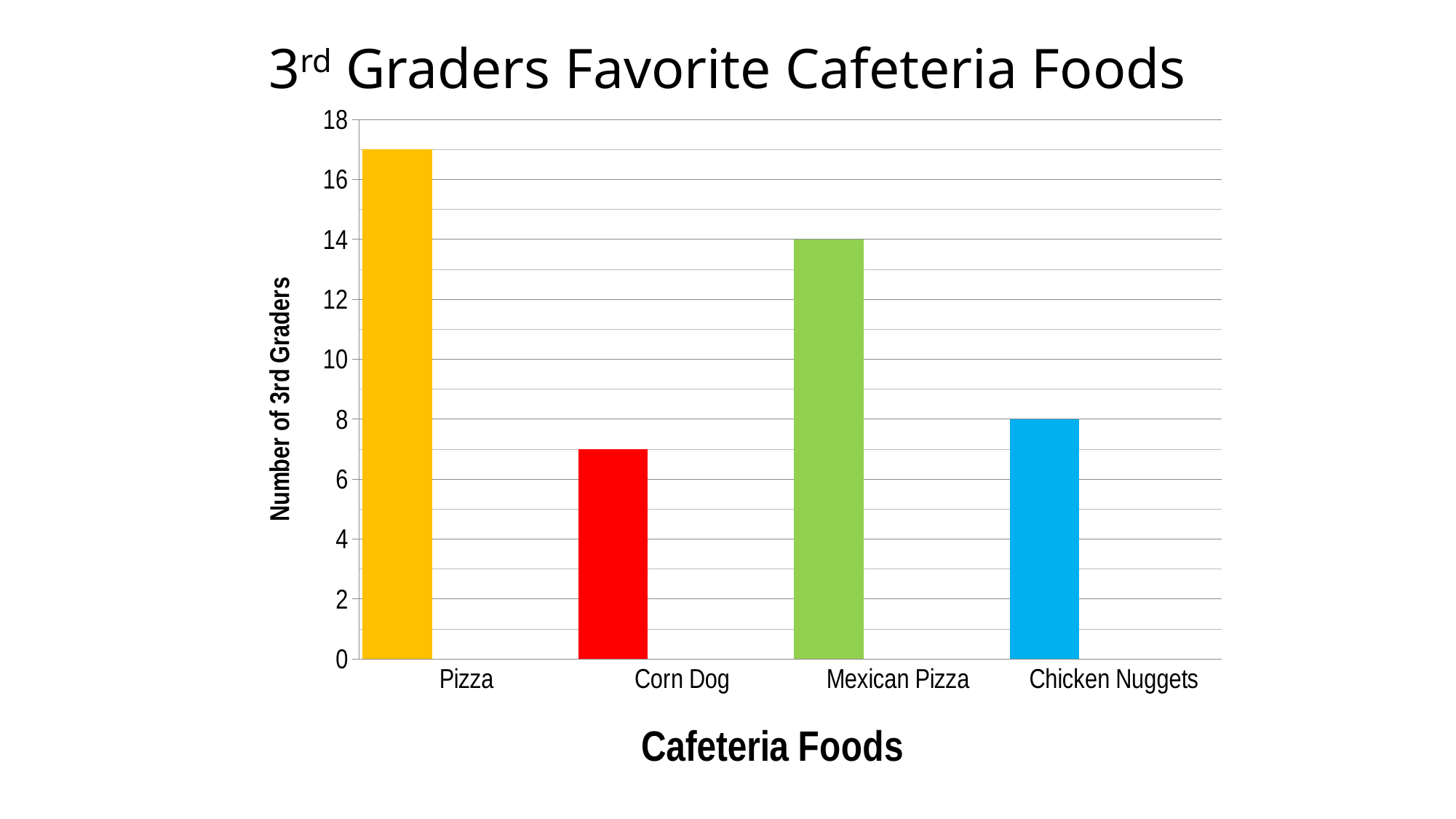
What is the difference between the number of 3rd graders who chose Mexican Pizza and those who chose Chicken Nuggets? 6 Which has more 3rd graders, Pizza or Mexican Pizza? Pizza Which cafeteria food has the highest number of 3rd graders? Pizza Which cafeteria food has the lowest number of 3rd graders? Corn Dog How many 3rd graders chose Chicken Nuggets? 8 Is the value for Corn Dog greater or less than 8? less What is the title of the chart? 3rd Graders Favorite Cafeteria Foods What is the label of the y axis? Number of 3rd Graders How many cafeteria foods are shown on the x axis? 4 Is the value for Pizza greater or less than 16? greater What kind of chart is shown on the slide? bar chart How many 3rd graders chose Mexican Pizza? 14